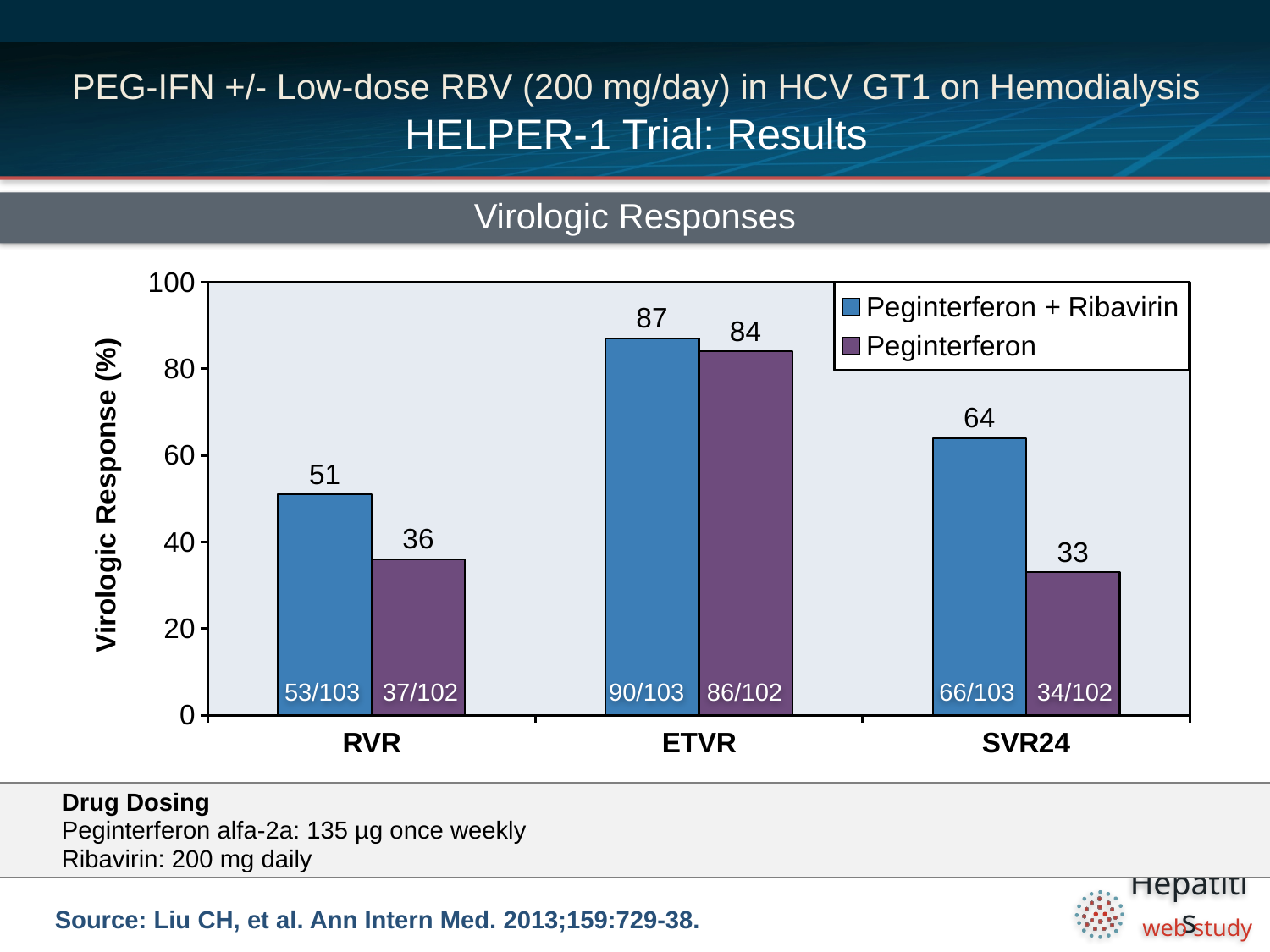
What kind of chart is shown? Bar chart How many response categories are shown on the x axis? 3 What is the difference between the Peginterferon + Ribavirin and Peginterferon responses at RVR? 15 Which is larger at ETVR: the Peginterferon + Ribavirin response or the Peginterferon response? Peginterferon + Ribavirin What is the difference between the Peginterferon + Ribavirin and Peginterferon responses at SVR24? 31 What is the virologic response for Peginterferon alone at ETVR? 84 How many series does the legend list? 2 At which time point is the Peginterferon alone response lowest? SVR24 What fraction is printed inside the Peginterferon + Ribavirin bar at SVR24? 66/103 What is the virologic response for Peginterferon alone at RVR? 36 At which time point is the Peginterferon + Ribavirin response highest? ETVR What is the virologic response for Peginterferon + Ribavirin at SVR24? 64